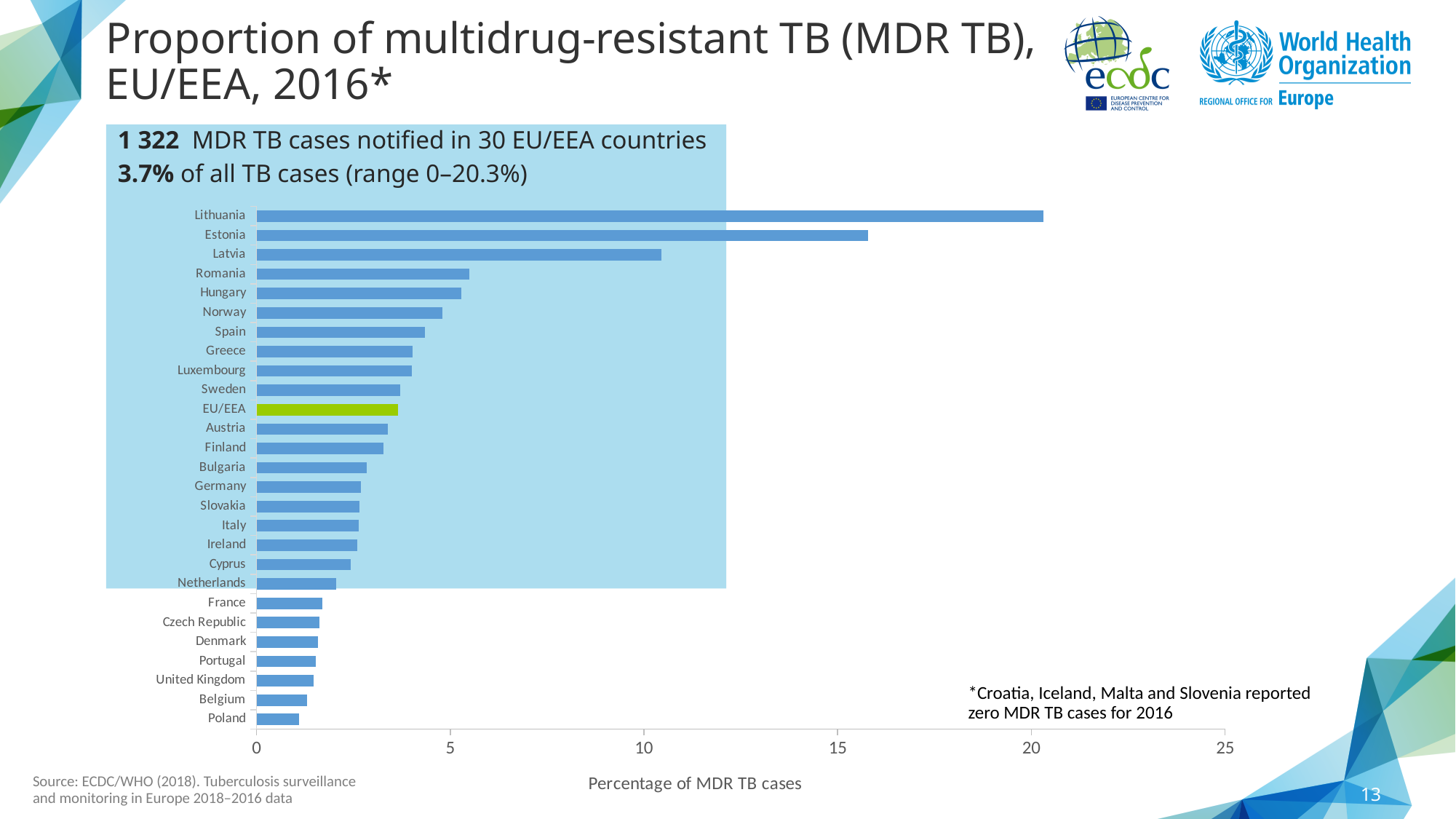
Is the value for Lithuania greater or less than 20? greater Is the value for Estonia greater or less than 15? greater What kind of chart is shown on the slide? bar chart Is the value for Norway greater or less than 5? less What is the proportion of MDR TB cases for EU/EEA overall? 3.7% Which country has the lowest proportion of MDR TB cases among those plotted? Poland Which has a higher proportion of MDR TB cases, Estonia or Latvia? Estonia What is the label of the horizontal axis? Percentage of MDR TB cases Which bar is coloured green rather than blue? EU/EEA How many bars are plotted in the chart? 27 Which country has the highest proportion of MDR TB cases? Lithuania